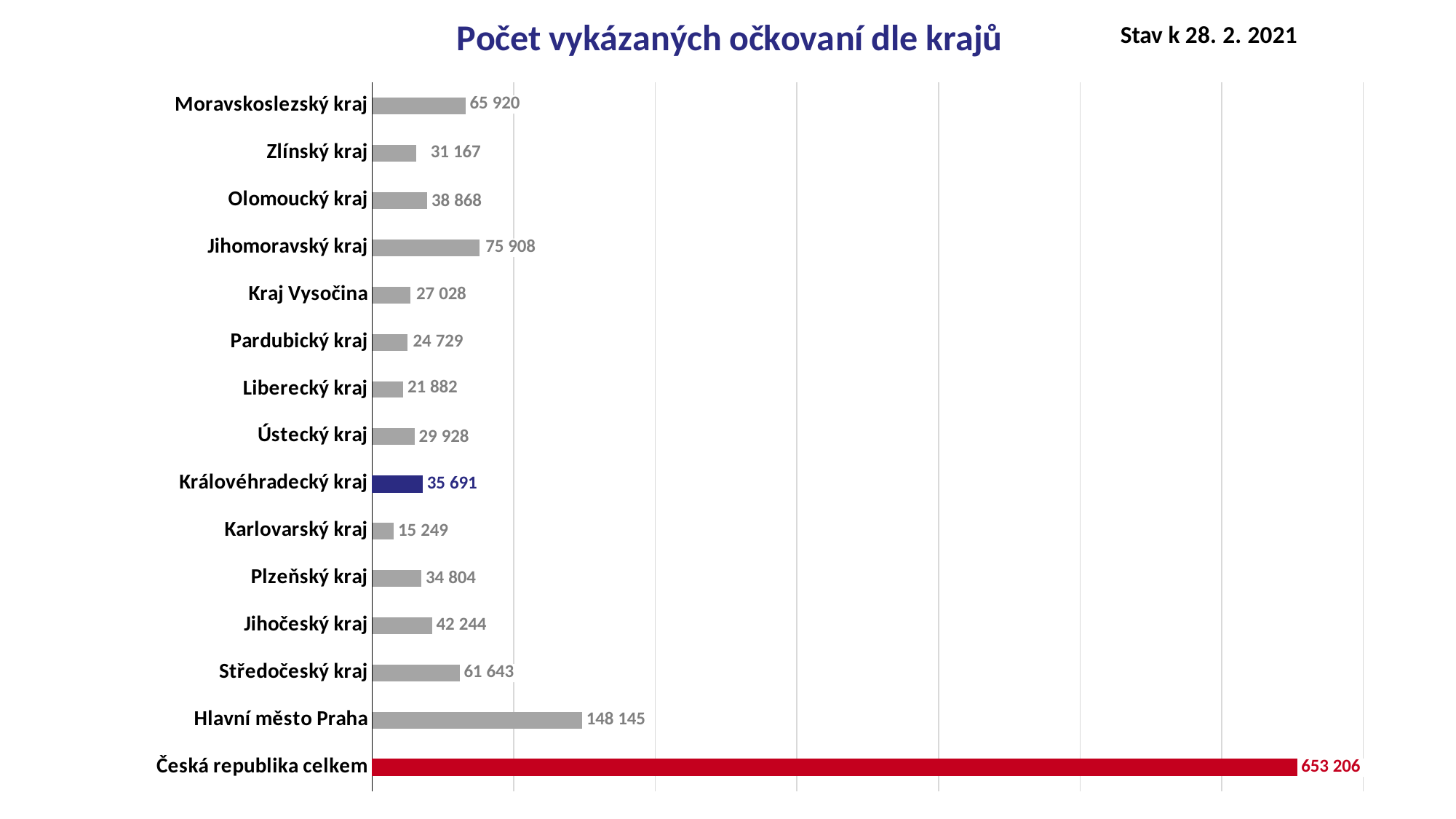
What is the difference between the values for Hlavní město Praha and Středočeský kraj? 86 502 What is the value for Karlovarský kraj? 15 249 Which is larger, the value for Zlínský kraj or the value for Olomoucký kraj? Olomoucký kraj What is the value for Královéhradecký kraj? 35 691 What type of chart is shown on the slide? bar chart What is the value for Hlavní město Praha? 148 145 Which region (excluding the Česká republika celkem total) has the highest value? Hlavní město Praha What is the difference between the values for Jihomoravský kraj and Olomoucký kraj? 37 040 Which category has the lowest value? Karlovarský kraj What is the title of the chart? Počet vykázaných očkovaní dle krajů What is the value for Česká republika celkem? 653 206 How many bars are shown in the chart? 15